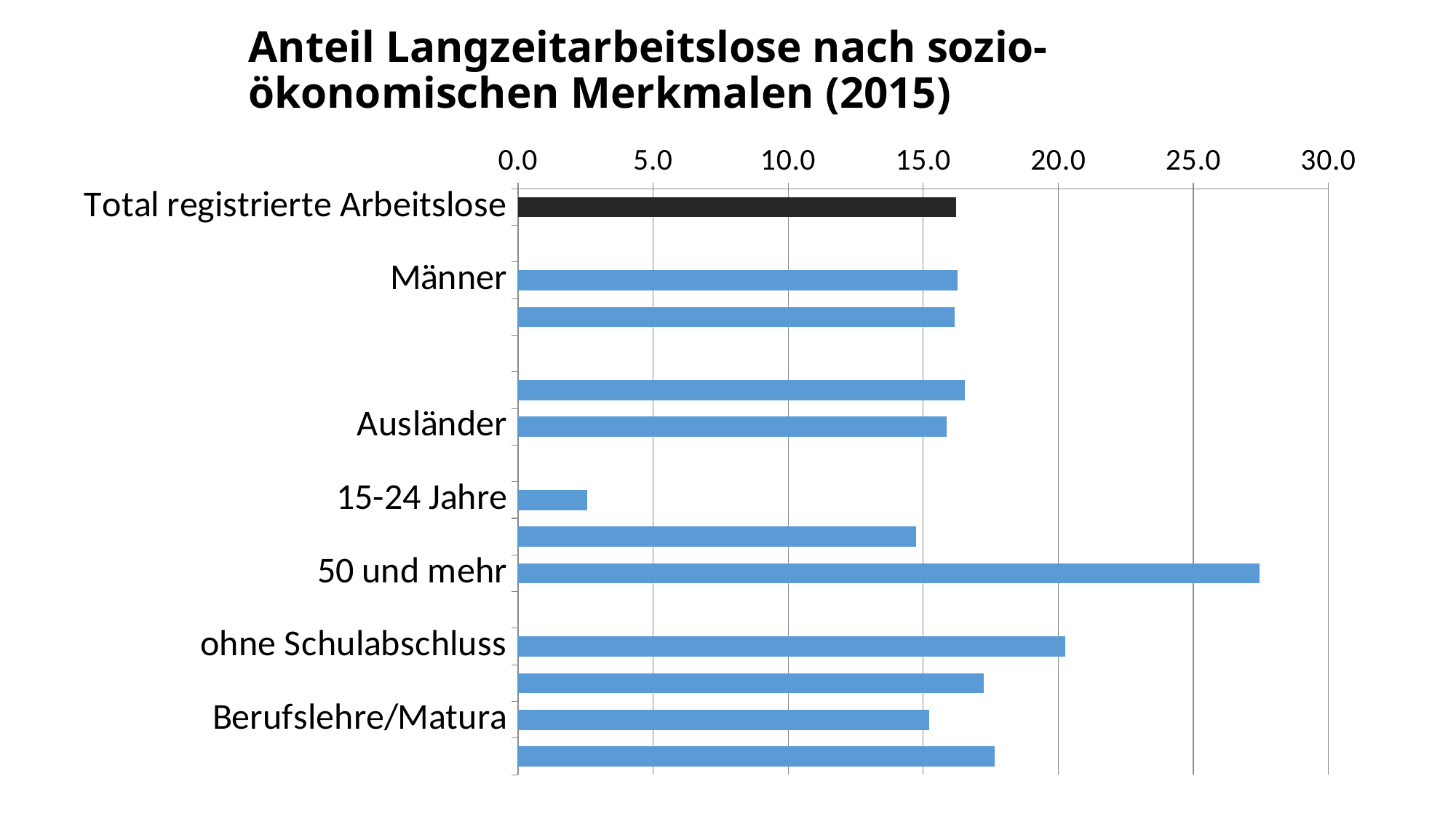
Is the value for Total registrierte Arbeitslose greater or less than 20.0? less Is the value for ohne Schulabschluss greater or less than 15.0? greater Is the value for 50 und mehr greater or less than 25.0? greater What is the title of the chart? Anteil Langzeitarbeitslose nach sozio-ökonomischen Merkmalen (2015) Which is larger, the value for 50 und mehr or the value for ohne Schulabschluss? 50 und mehr Which labelled category has the highest value? 50 und mehr What kind of chart is shown on the slide? bar chart Which is larger, the value for 15-24 Jahre or the value for Ausländer? Ausländer What colour is the bar for Total registrierte Arbeitslose? black Which labelled category has the lowest value? 15-24 Jahre